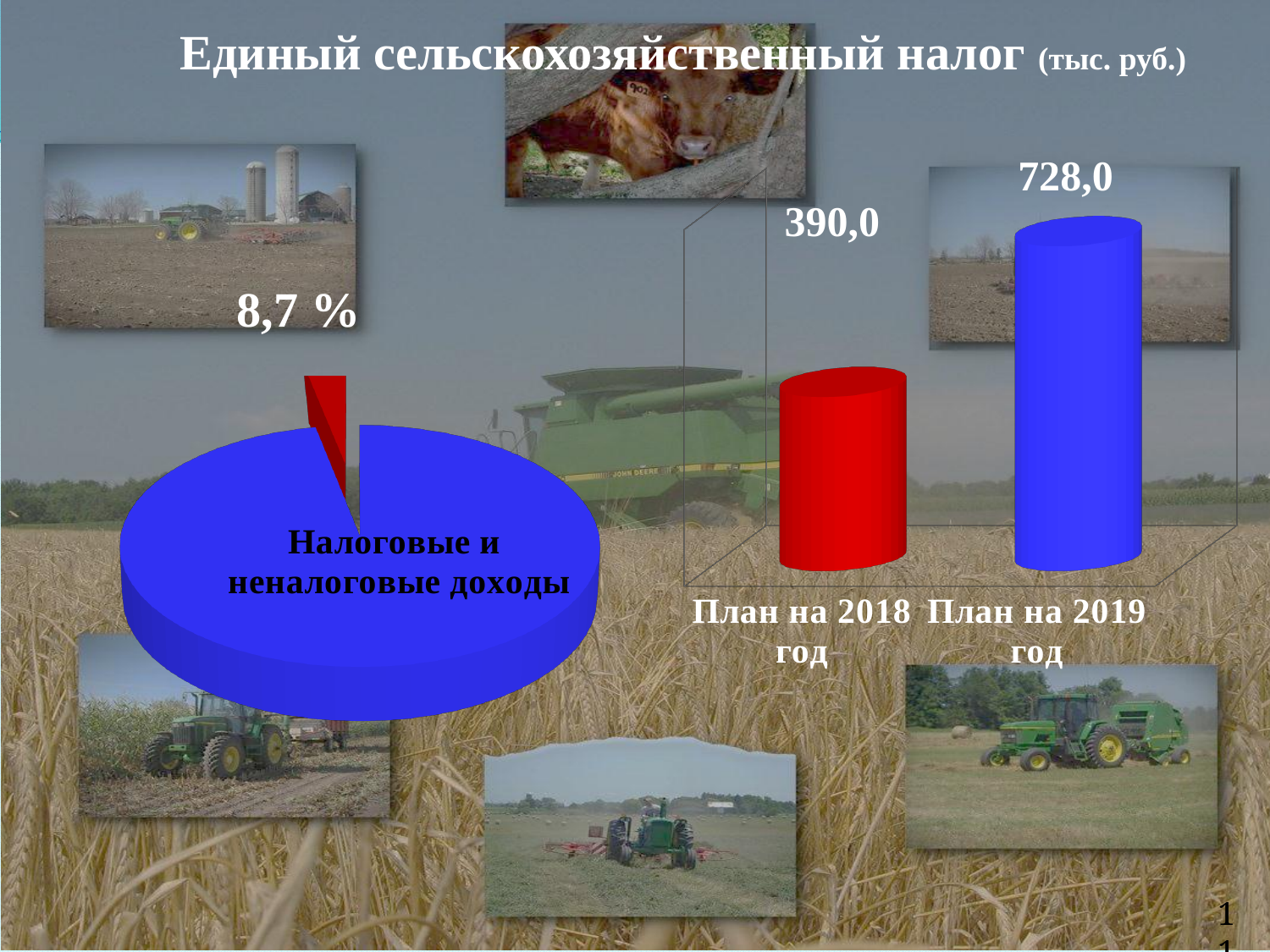
On the bar chart on the right, which category has the highest value? План на 2019 год On the bar chart on the right, which is larger: the value for План на 2018 год or the value for План на 2019 год? План на 2019 год On the bar chart on the right, do the values rise or fall from План на 2018 год to План на 2019 год? Rise On the bar chart on the right, what is the value for План на 2018 год? 390,0 What kind of chart is shown on the right side of the slide? Bar chart On the pie chart on the left, what share is shown for the small red slice? 8,7 % On the bar chart on the right, what is the value for План на 2019 год? 728,0 What is the title of the slide's chart? Единый сельскохозяйственный налог (тыс. руб.) On the bar chart on the right, what is the difference between the values for План на 2019 год and План на 2018 год? 338,0 What kind of chart is shown on the left side of the slide? Pie chart On the bar chart on the right, how many bars are plotted? 2 On the bar chart on the right, which category has the lowest value? План на 2018 год